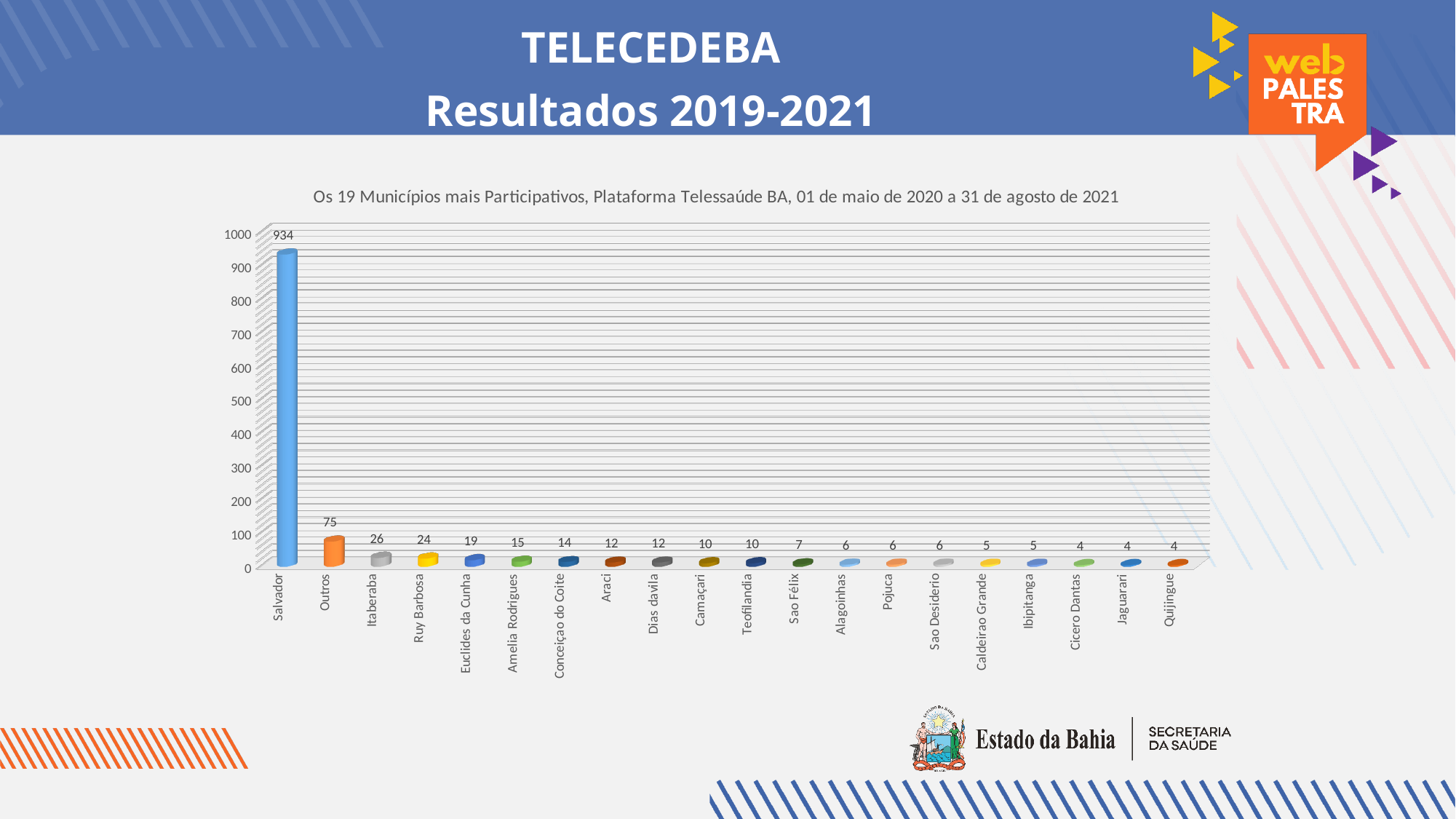
Is the value for Salvador greater or less than 900? greater What is the value for Salvador? 934 What is the value for Camaçari? 10 Which category has the highest value? Salvador What is the value for Euclides da Cunha? 19 How many bars are plotted in the chart? 20 What is the value for Outros? 75 What is the difference between the values for Itaberaba and Ruy Barbosa? 2 What is the difference between the values for Salvador and Outros? 859 Which is larger, the value for Amelia Rodrigues or the value for Araci? Amelia Rodrigues What is the value for Itaberaba? 26 What kind of chart is shown on the slide? Bar chart